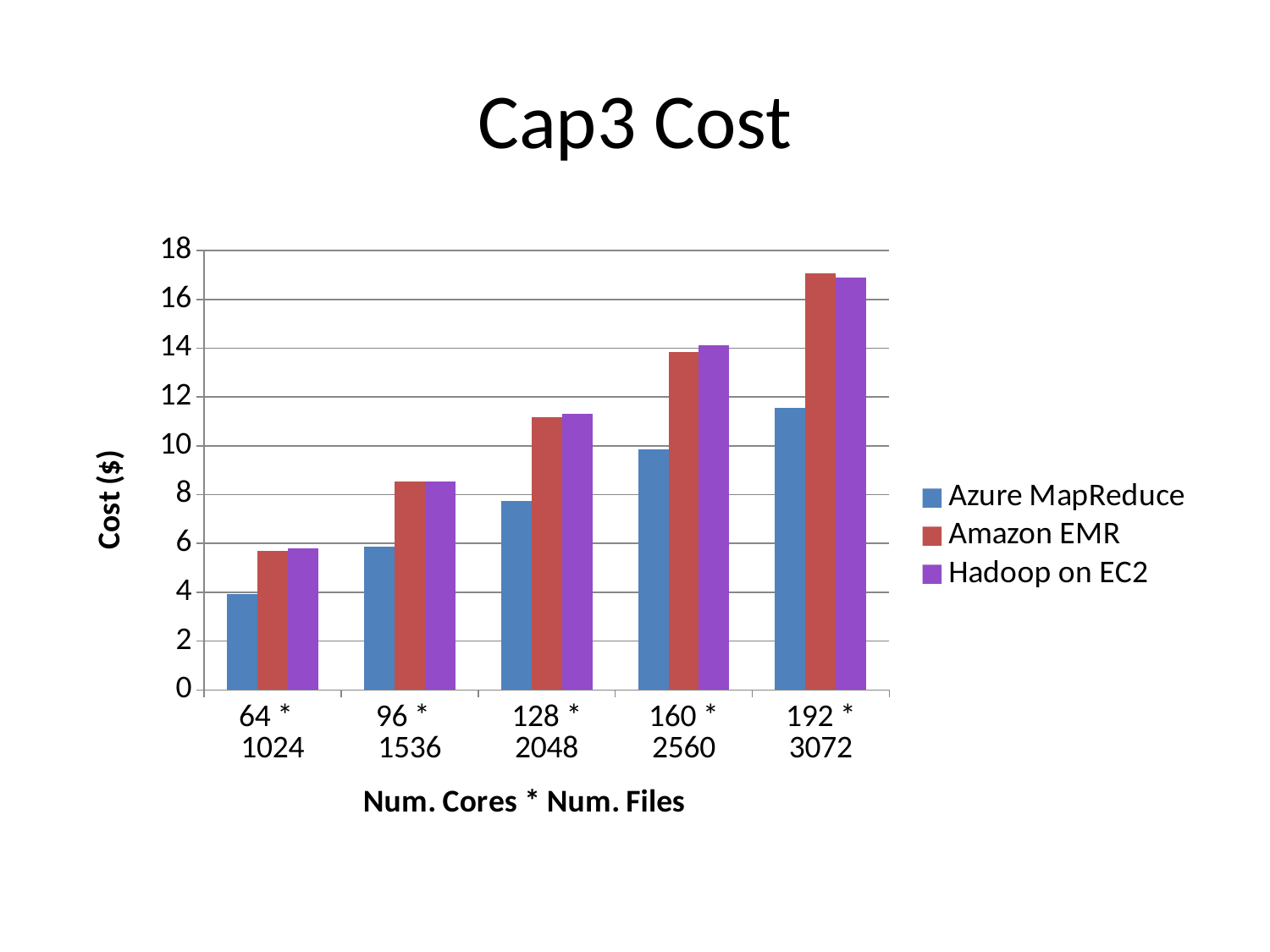
Which series has the lowest value at 128 * 2048? Azure MapReduce Do the Azure MapReduce values rise or fall as you move from 64 * 1024 to 192 * 3072? rise How many categories are shown on the x axis? 5 What is the title of the y axis? Cost ($) Is the value for Hadoop on EC2 at 64 * 1024 greater or less than 8? less Which category has the lowest Azure MapReduce value? 64 * 1024 What is the title of the x axis? Num. Cores * Num. Files At 160 * 2560, which is larger: Azure MapReduce or Amazon EMR? Amazon EMR Is the value for Azure MapReduce at 192 * 3072 greater or less than 10? greater Is the value for Amazon EMR at 192 * 3072 greater or less than 16? greater How many series does the legend list? 3 What kind of chart is shown on the slide? bar chart